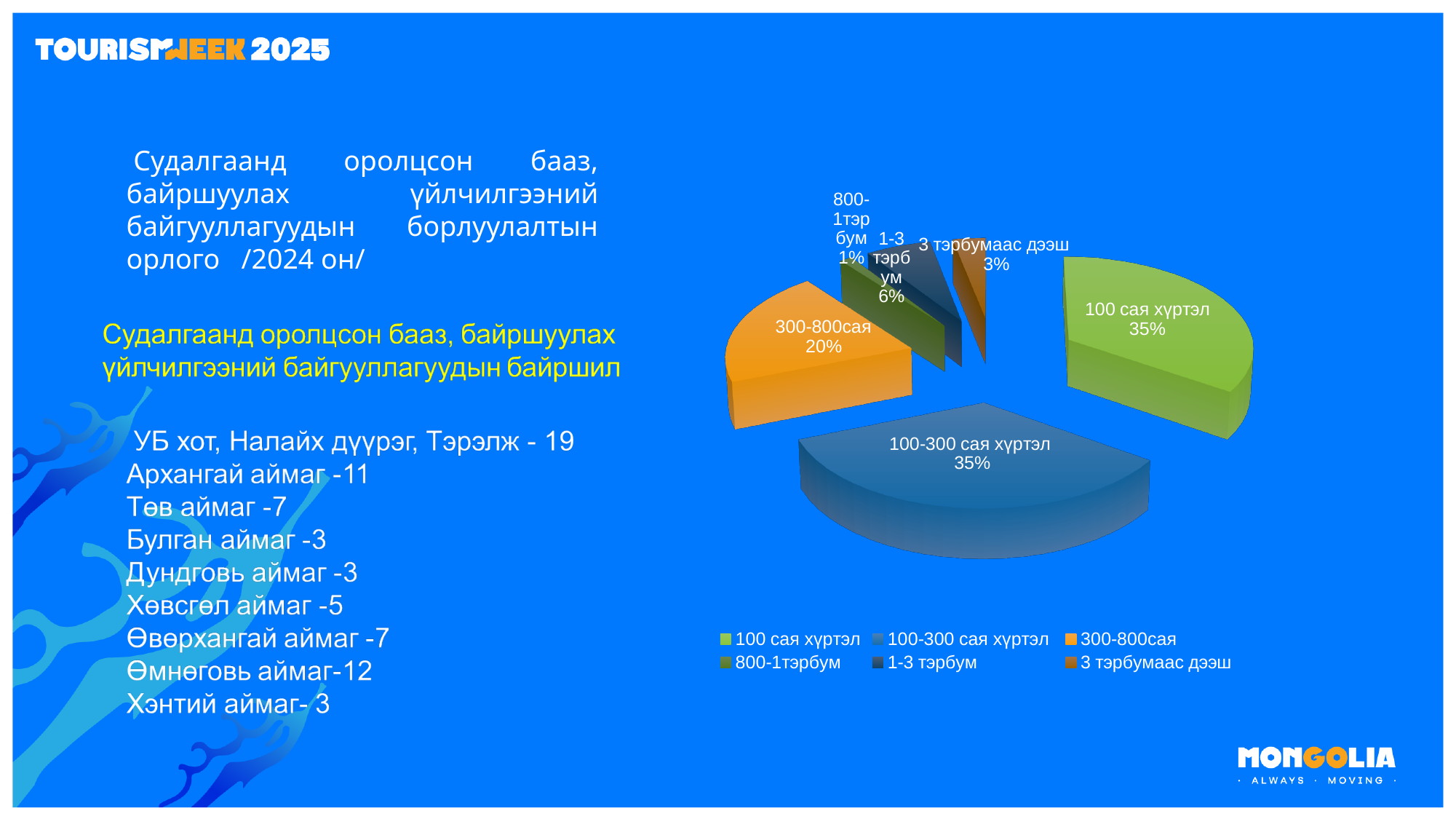
What colour is the "300-800сая" slice in the pie chart? orange What share of the pie does the "300-800сая" slice represent? 20% What is the difference in percentage points between the "1-3 тэрбум" slice and the "3 тэрбумаас дээш" slice? 3 How many entries does the legend of the pie chart list? 6 What share of the pie does the "3 тэрбумаас дээш" slice represent? 3% What share of the pie does the "1-3 тэрбум" slice represent? 6% What kind of chart is shown on the slide? pie chart Which slice of the pie chart is the smallest? 800-1тэрбум How many slices does the pie chart have? 6 Which is larger in the pie chart: "300-800сая" or "1-3 тэрбум"? 300-800сая What is the difference in percentage points between the "100-300 сая хүртэл" slice and the "300-800сая" slice? 15